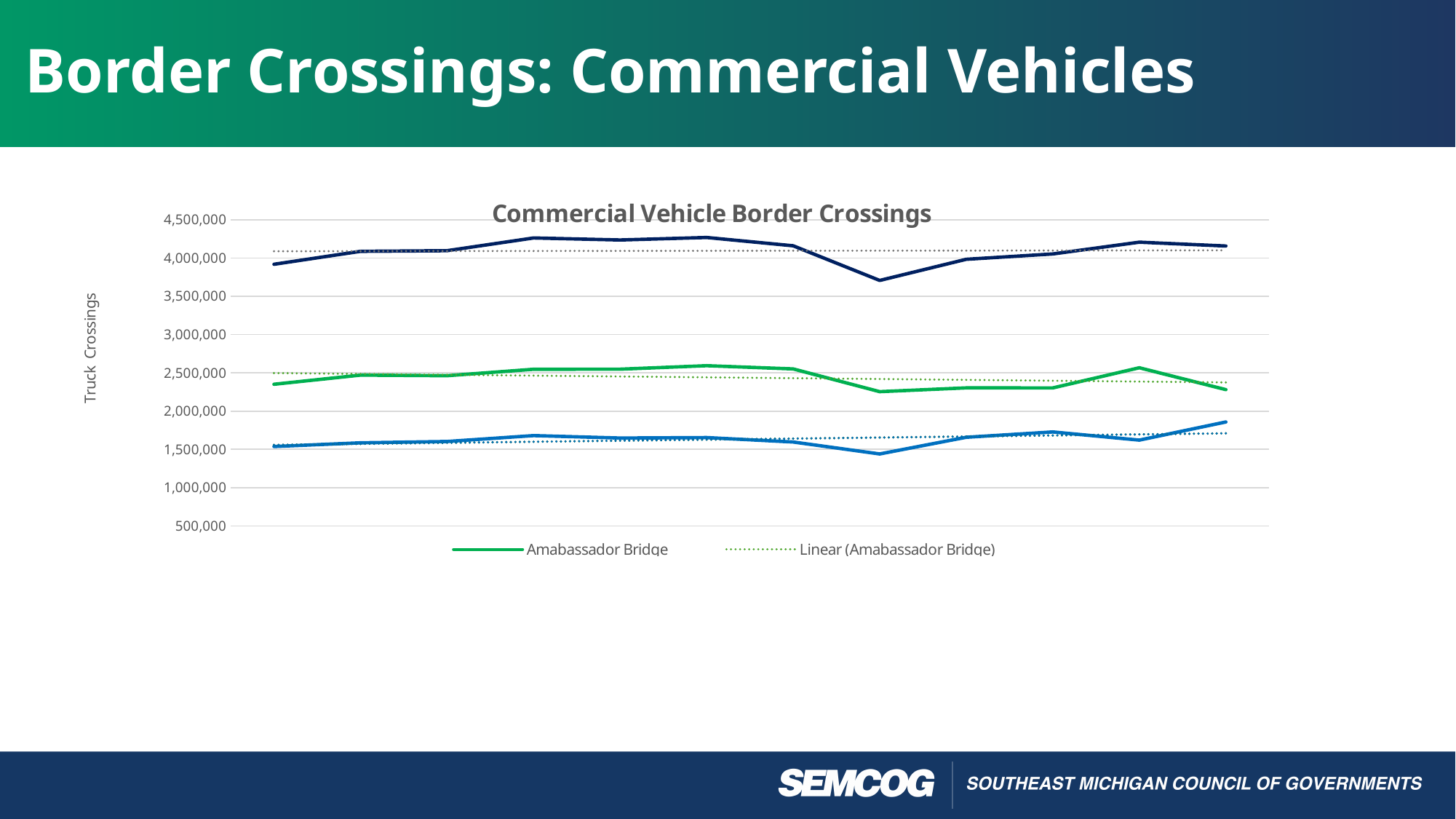
How many entries are visible in the chart's legend? 2 Is the highest point of the Amabassador Bridge line greater or less than 2,500,000? greater Is the leftmost value of the Amabassador Bridge line greater or less than 2,500,000? less What is the title of the chart? Commercial Vehicle Border Crossings Is the Amabassador Bridge line the highest of the solid lines plotted on the chart? No What is the label on the vertical axis of the chart? Truck Crossings Does the Amabassador Bridge line ever drop below 2,000,000? No What is the highest value shown on the vertical axis? 4,500,000 What kind of chart is shown on the slide? Line chart Does the Linear (Amabassador Bridge) trend line rise or fall from left to right? Falls slightly